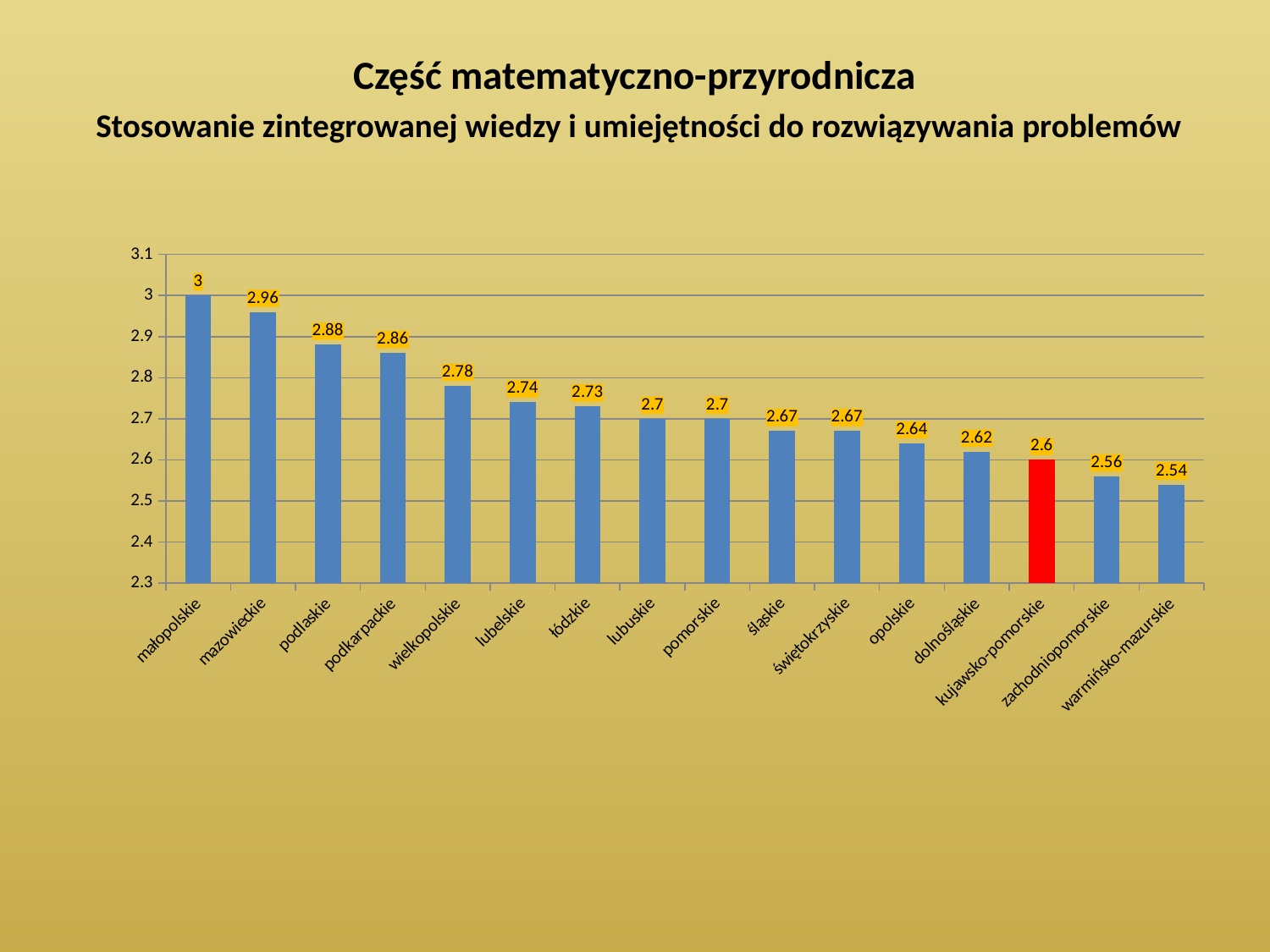
Which region's bar is coloured red? kujawsko-pomorskie How many regions are shown on the chart? 16 What is the value for małopolskie? 3 Which region has the lowest value? warmińsko-mazurskie What is the value for wielkopolskie? 2.78 Do the values rise or fall from left to right along the x axis? fall Is the value for zachodniopomorskie greater or less than 2.6? less What kind of chart is shown on the slide? bar chart Which has a larger value, opolskie or dolnośląskie? opolskie Which region has the highest value? małopolskie What is the difference between the values for mazowieckie and podlaskie? 0.08 What is the value for kujawsko-pomorskie? 2.6